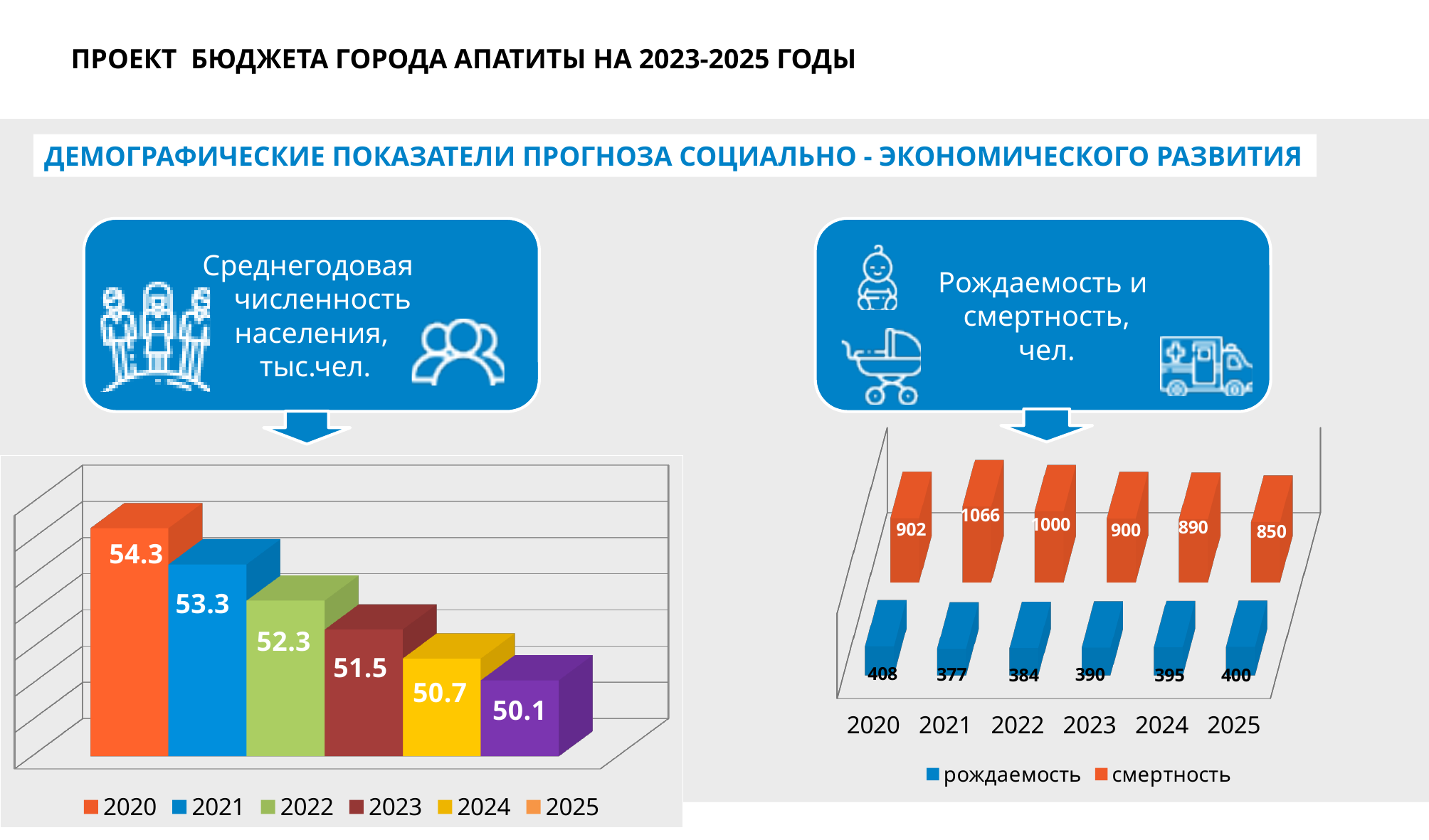
In the left chart (Среднегодовая численность населения), which year has the lowest value? 2025 In the right chart (Рождаемость и смертность), what is the difference between смертность and рождаемость in 2025? 450 In the left chart (Среднегодовая численность населения), what is the value for 2025? 50.1 In the right chart (Рождаемость и смертность), what is the смертность value for 2021? 1066 In the right chart (Рождаемость и смертность), which year has the highest смертность value? 2021 In the left chart (Среднегодовая численность населения), how many bars are plotted? 6 In the left chart (Среднегодовая численность населения), what is the difference between the 2020 and 2025 values? 4.2 In the left chart (Среднегодовая численность населения), do the values rise or fall from 2020 to 2025? fall In the right chart (Рождаемость и смертность), what is the рождаемость value for 2023? 390 In the right chart (Рождаемость и смертность), which year has the lowest рождаемость value? 2021 In the left chart (Среднегодовая численность населения), what is the value for 2020? 54.3 In the right chart (Рождаемость и смертность), how many series does the legend list? 2